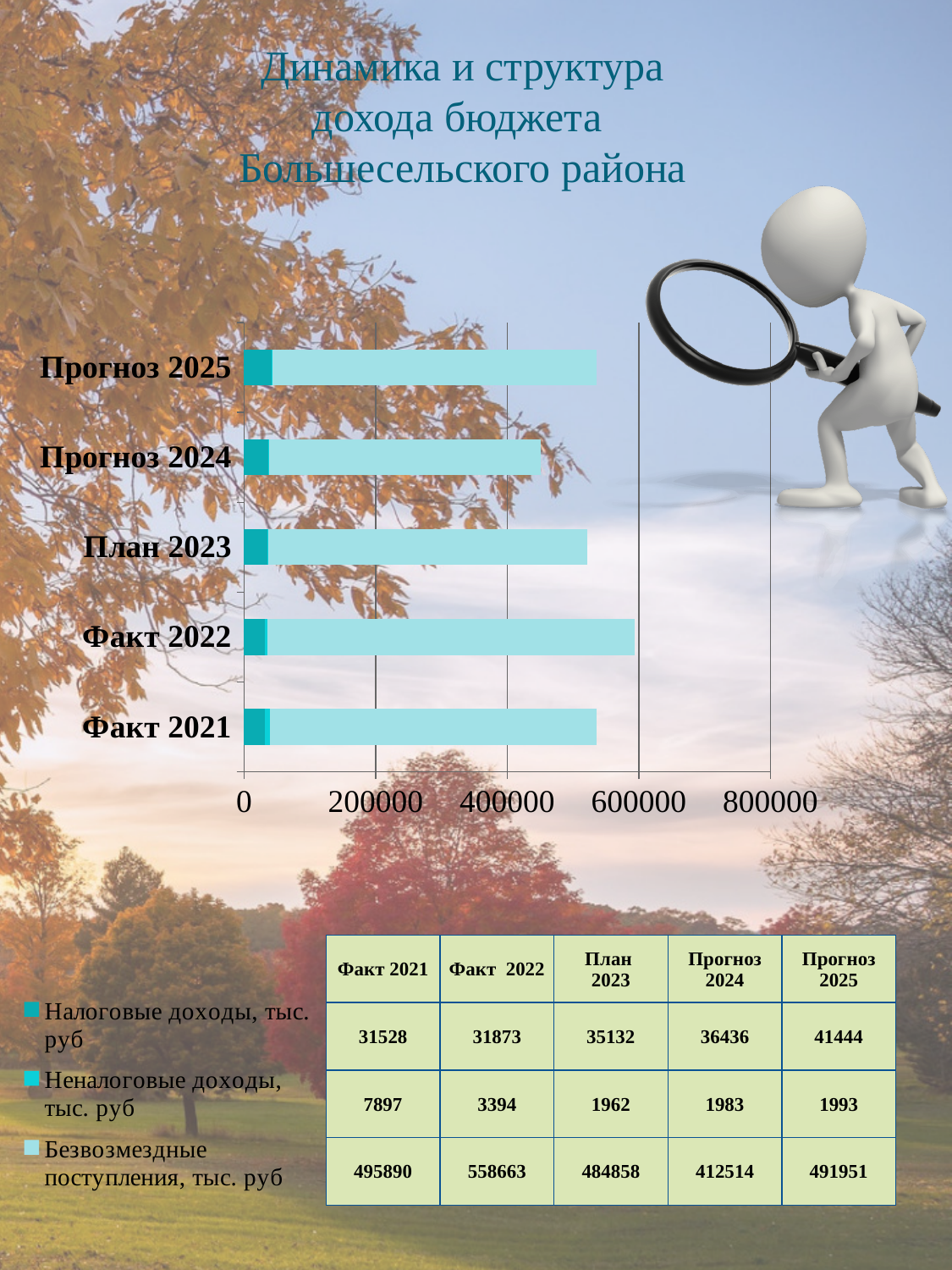
What is the value of Налоговые доходы for Прогноз 2025? 41444 What is the total of the stacked bar for Факт 2022? 593930 What type of chart is shown on the slide? Stacked bar chart Which category has the highest value of Безвозмездные поступления? Факт 2022 What is the value of Безвозмездные поступления for Факт 2022? 558663 Do the values of Налоговые доходы rise or fall from Факт 2021 to Прогноз 2025? Rise Which category has the lowest value of Неналоговые доходы? План 2023 How many series does the legend list? 3 Which is larger: Безвозмездные поступления for Факт 2022 or for Прогноз 2024? Факт 2022 What is the difference between Налоговые доходы for Прогноз 2025 and Факт 2021? 9916 What is the value of Неналоговые доходы for План 2023? 1962 How many categories (years) does the chart show? 5